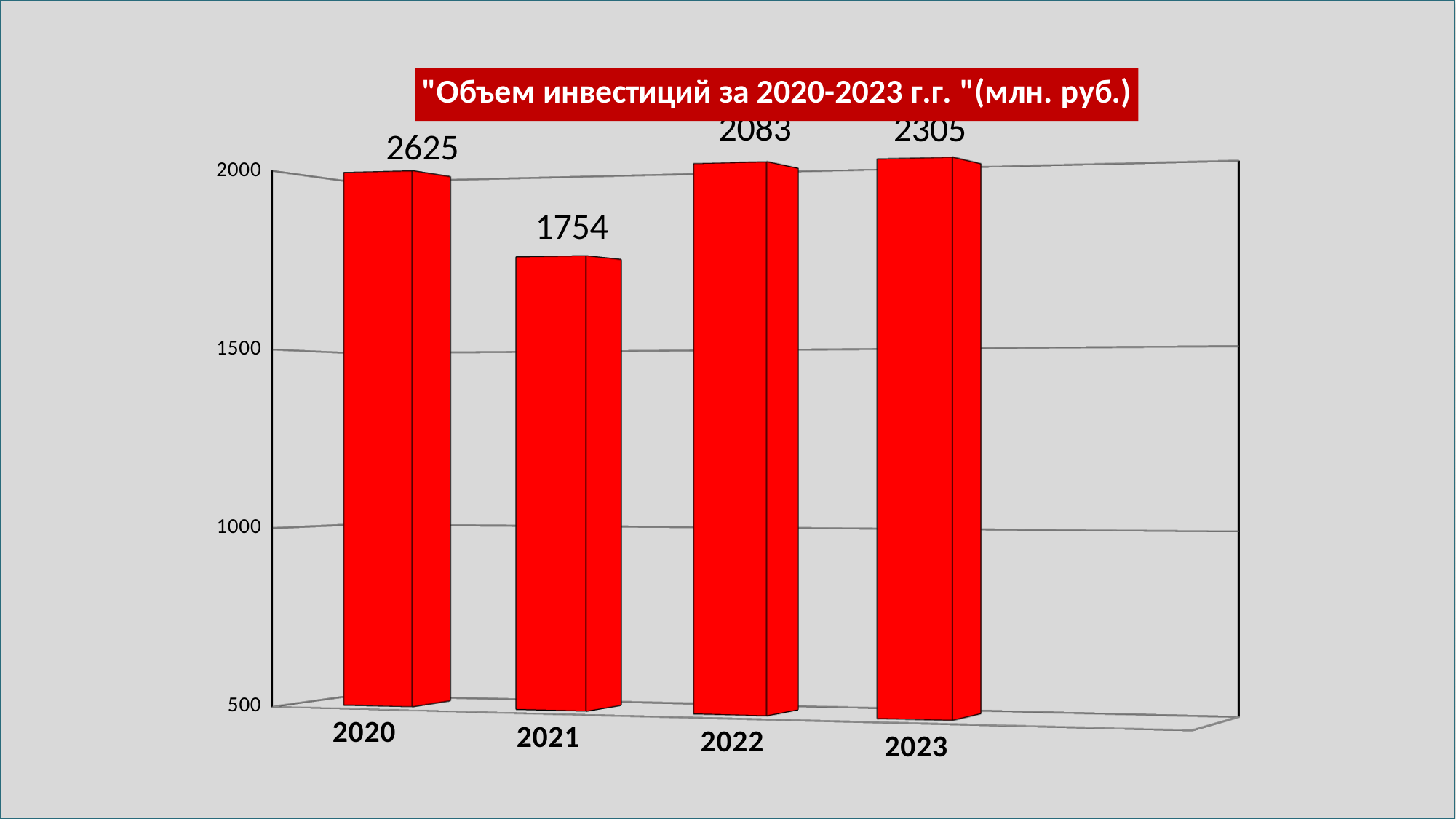
Is the value for 2021 greater or less than 2000? less Which is larger, the value for 2022 or the value for 2023? 2023 What is the value for 2022? 2083 How many years are shown on the x axis? 4 Which year has the lowest value? 2021 Which year has the highest value? 2020 What is the value for 2023? 2305 What is the difference between the values for 2023 and 2022? 222 What kind of chart is shown on the slide? bar chart What is the value for 2020? 2625 What is the difference between the values for 2020 and 2021? 871 What is the value for 2021? 1754